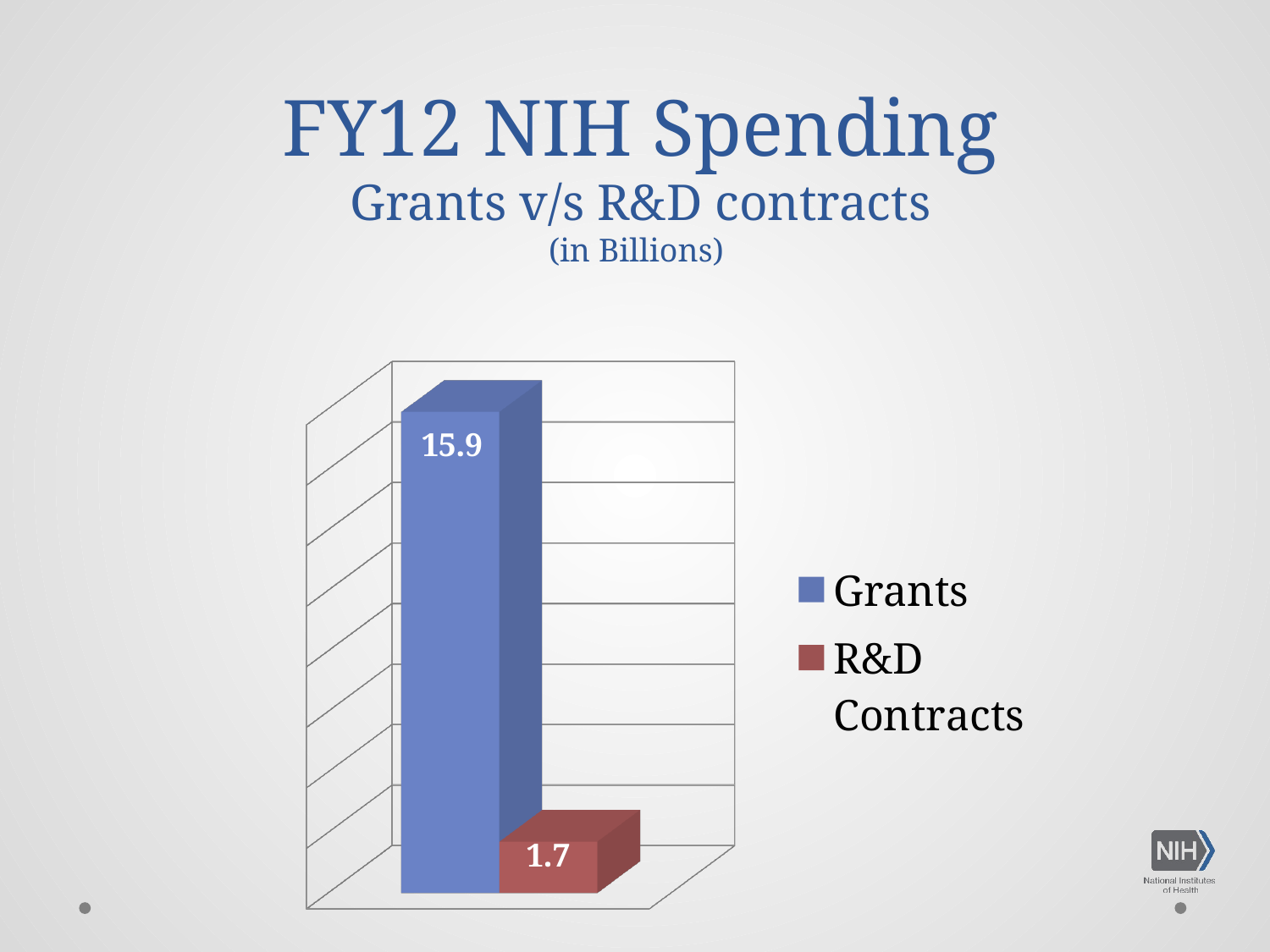
How many series does the legend list? 2 What is the value for R&D Contracts? 1.7 Which is larger, Grants or R&D Contracts? Grants Which series has the highest value? Grants What is the total of the Grants and R&D Contracts values? 17.6 Which series has the lowest value? R&D Contracts What is the title of the slide's chart? FY12 NIH Spending What is the value for Grants? 15.9 What kind of chart is shown on the slide? Bar chart What colour is the Grants bar? Blue What is the difference between the Grants value and the R&D Contracts value? 14.2